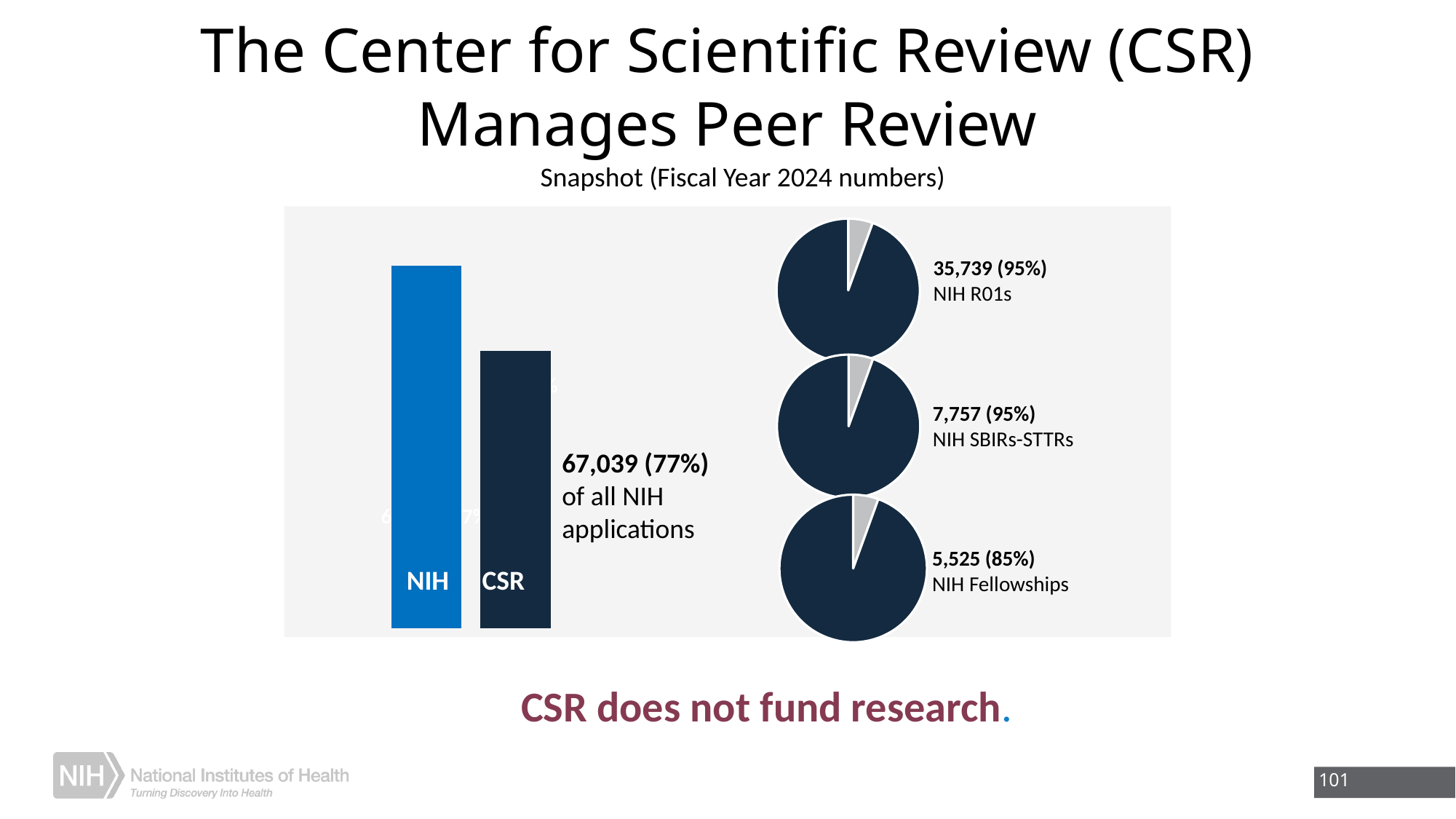
What kind of charts are shown on the right side of the slide next to the NIH R01s, NIH SBIRs-STTRs and NIH Fellowships labels? pie chart In the bar chart on the left, how many bars are plotted? 2 What kind of chart is shown on the left side of the slide, with the NIH and CSR bars? bar chart In the bar chart on the left, what number of applications is printed for CSR? 67,039 Among the three pie charts on the right, which category has the lowest printed percentage? NIH Fellowships In the bottom pie chart on the right, what percentage is printed for NIH Fellowships? 85% In the middle pie chart on the right, what number is printed for NIH SBIRs-STTRs? 7,757 In the bar chart on the left, what percentage of all NIH applications does CSR account for? 77% In the bar chart on the left, which bar is taller, NIH or CSR? NIH In the top pie chart on the right, what value is printed for NIH R01s? 35,739 (95%) In the bar chart on the left, which category has the lowest bar? CSR How many pie charts are shown on the right side of the slide? 3